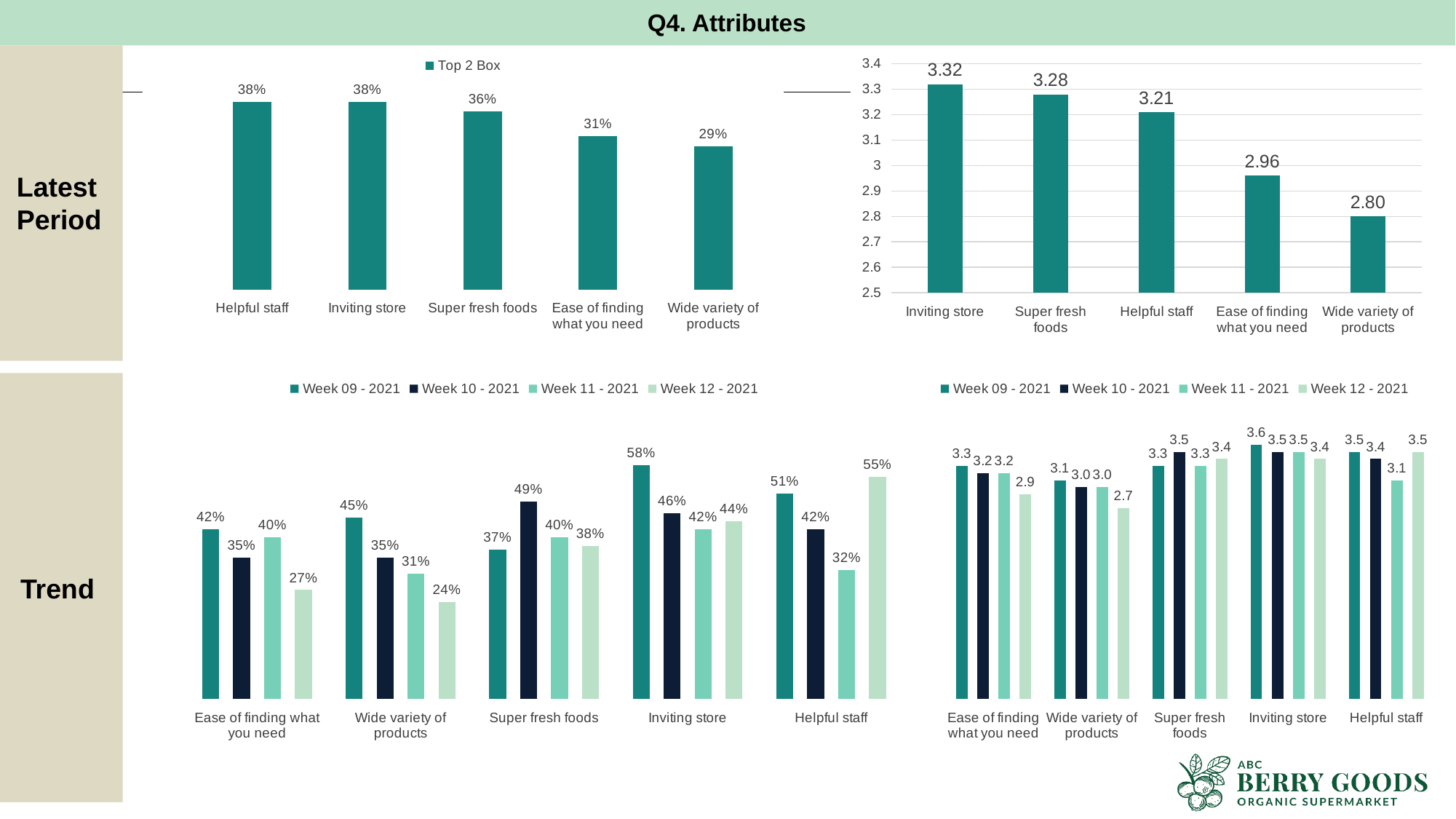
In the top-right Latest Period chart, how many categories are shown? 5 In the top-right Latest Period chart, what is the value for Ease of finding what you need? 2.96 In the bottom-left Trend chart, which is larger for Helpful staff: Week 09 - 2021 or Week 12 - 2021? Week 12 - 2021 In the top-left Latest Period chart (Top 2 Box), what is the difference between Helpful staff and Ease of finding what you need? 7% What kind of chart is the bottom-right Trend chart? Bar chart In the top-left Latest Period chart (Top 2 Box), what is the value for Super fresh foods? 36% In the bottom-left Trend chart, how many series does the legend list? 4 In the top-left Latest Period chart (Top 2 Box), which category has the lowest value? Wide variety of products In the top-right Latest Period chart, is the value for Wide variety of products greater or less than 3? less In the top-right Latest Period chart, which category has the highest value? Inviting store In the bottom-right Trend chart, what is the value for Wide variety of products in Week 12 - 2021? 2.7 In the bottom-left Trend chart, what is the value for Inviting store in Week 09 - 2021? 58%